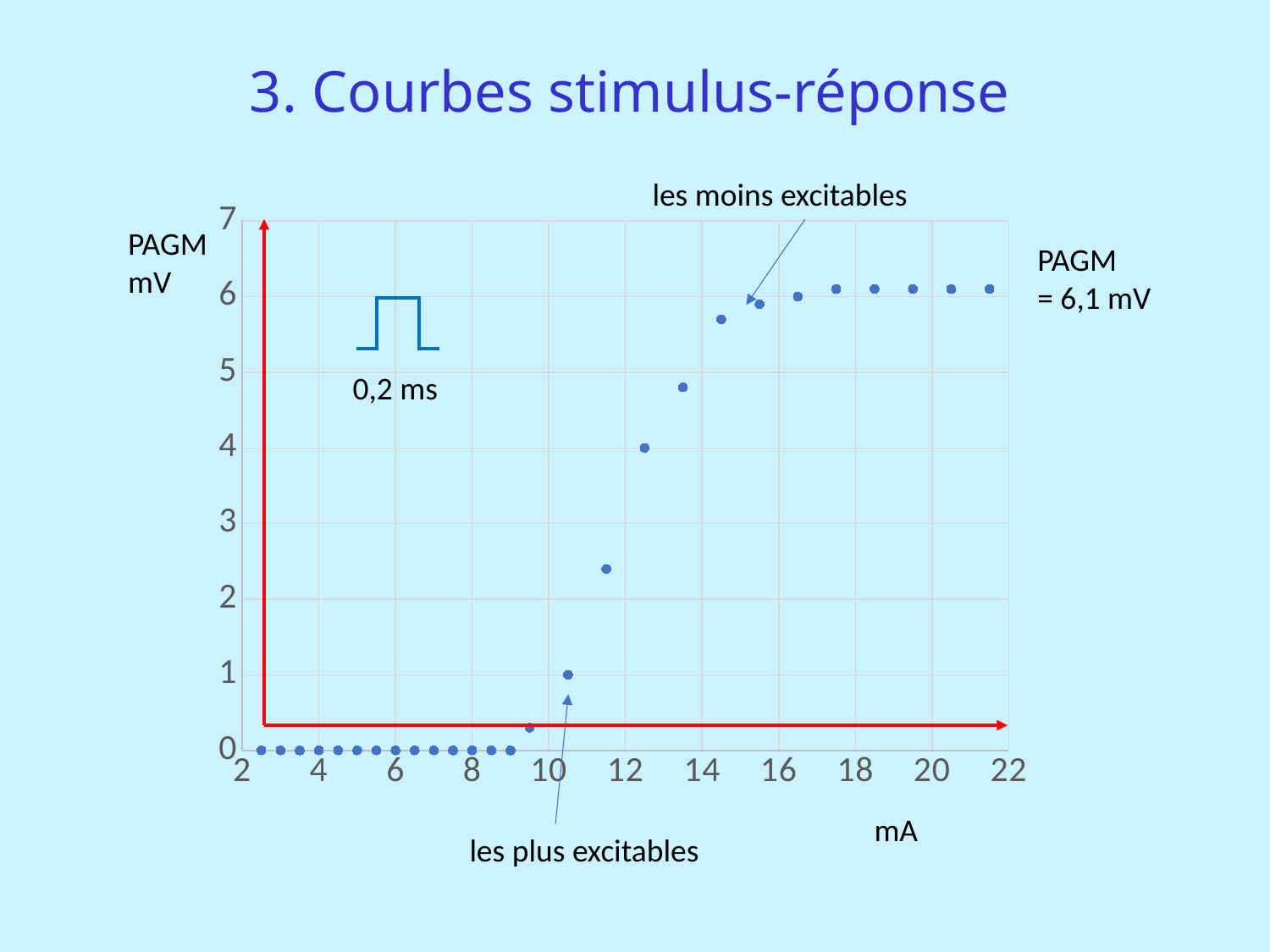
What is the highest value shown on the x axis? 22 Do the PAGM values rise or fall as the stimulus intensity increases from 10 mA to 16 mA? rise According to the annotation on the right of the chart, what PAGM value does the curve reach at its plateau? 6,1 mV Which annotation points to the first non-zero point of the curve? les plus excitables Is the PAGM value at 8 mA greater or less than 1? less Which is larger, the PAGM value at 12 mA or the PAGM value at 18 mA? 18 mA What stimulus duration is indicated next to the pulse symbol on the chart? 0,2 ms What is the highest value shown on the y axis? 7 What kind of chart is shown on the slide? scatter chart Is the PAGM value at 12 mA greater or less than 1? greater What is the PAGM value for stimulus intensities between 2 and 9 mA? 0 Is the PAGM value at 16 mA greater or less than 5? greater